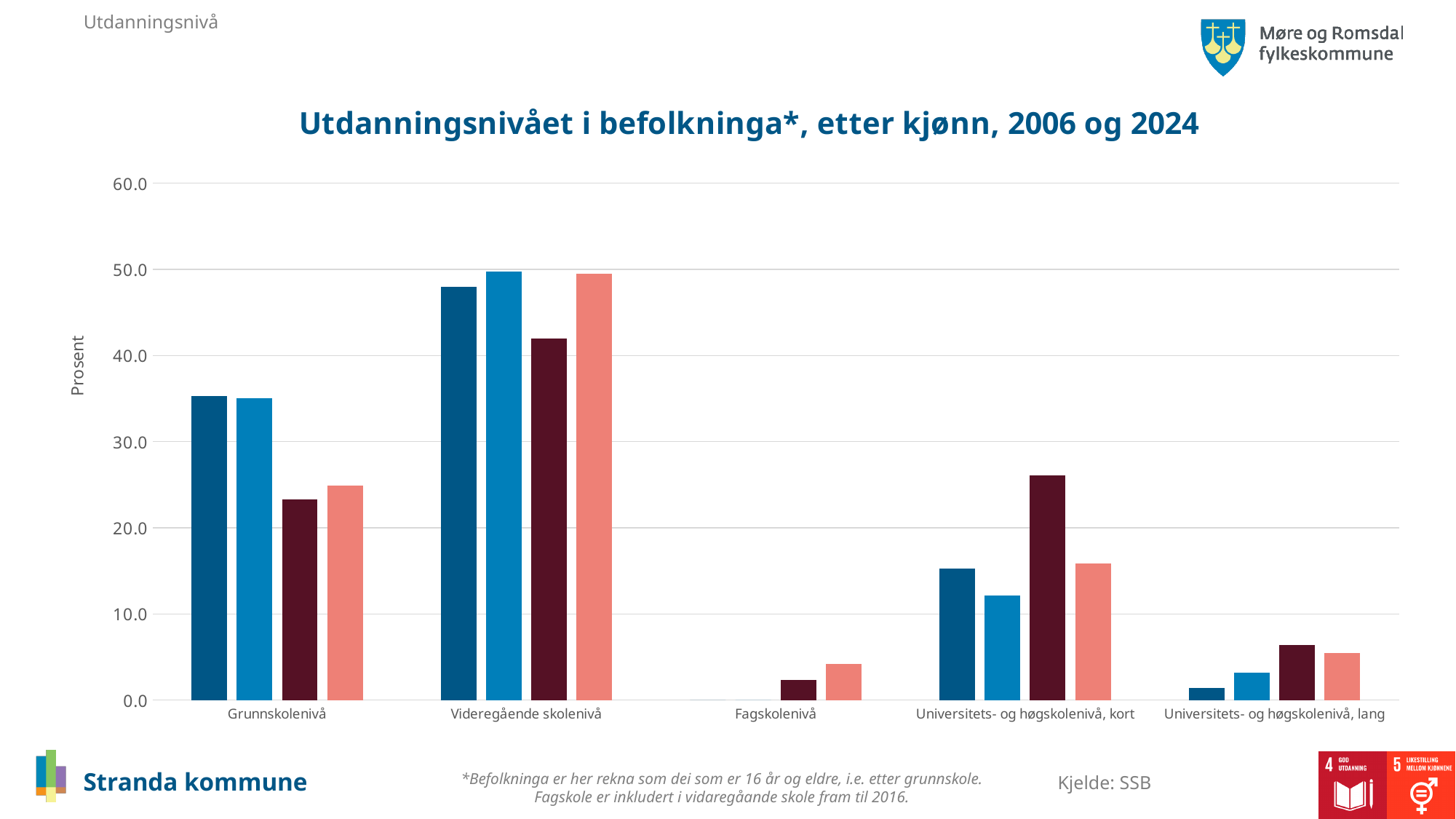
Is the value of the dark maroon bar for Universitets- og høgskolenivå, kort greater or less than 20? greater Is the value of the light blue bar for Universitets- og høgskolenivå, lang greater or less than 10? less Is the value of the third (dark maroon) bar for Videregående skolenivå greater or less than 40? greater What is the label on the vertical axis? Prosent Which category contains the tallest bar in the chart? Videregående skolenivå How many education-level categories are shown on the x axis? 5 For Grunnskolenivå, which is taller: the dark blue bar or the dark maroon bar? the dark blue bar Which category has the lowest bars overall? Fagskolenivå What is the title of the chart? Utdanningsnivået i befolkninga*, etter kjønn, 2006 og 2024 What kind of chart is shown on the slide? bar chart